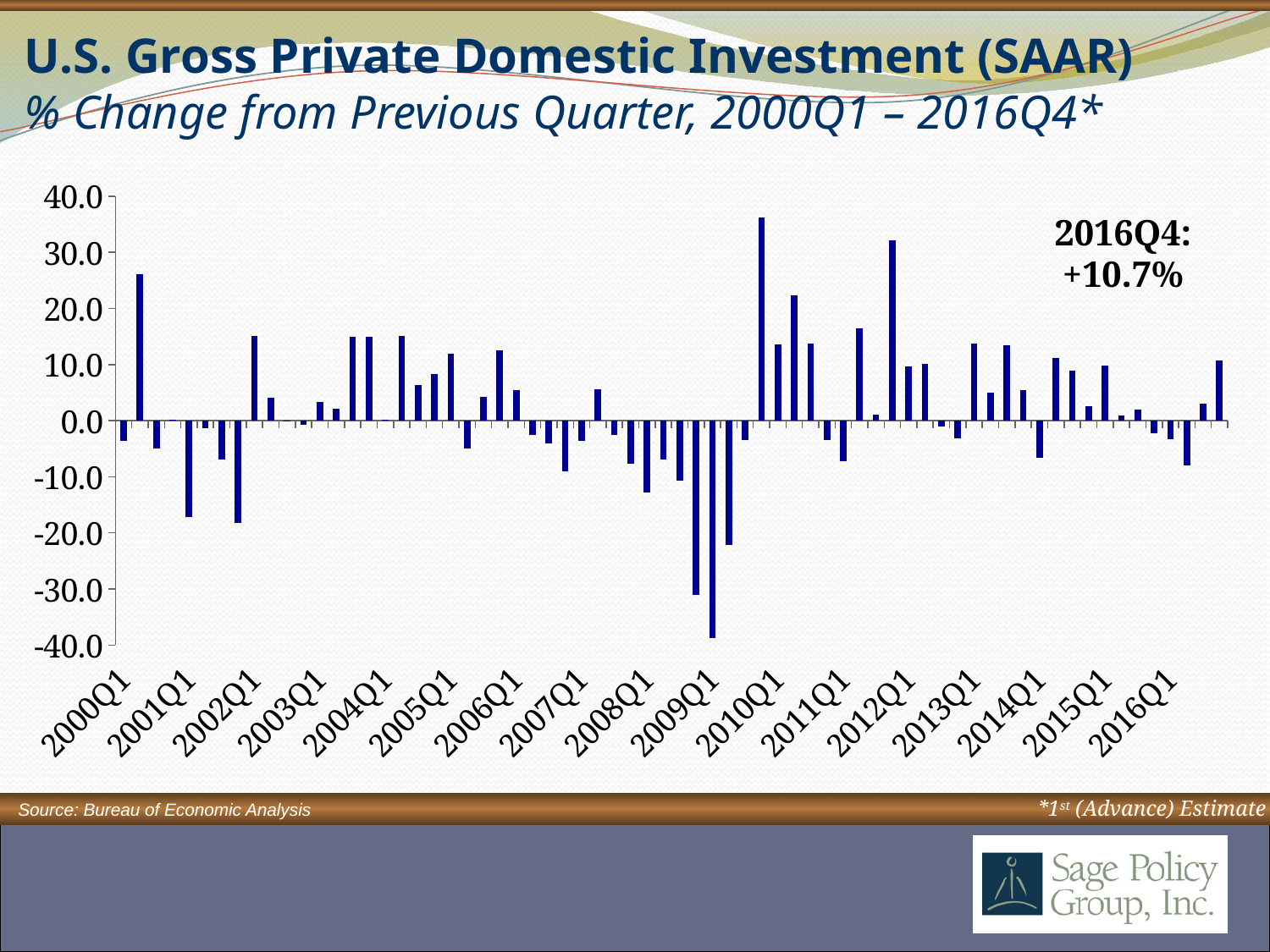
Is the value for 2016Q4 greater or less than 10? greater Is the value for 2016Q1 greater or less than 0? less Is the highest bar on the chart greater or less than 30? greater What is the value for 2016Q4? +10.7% What is the highest value shown on the y axis? 40.0 What kind of chart is shown on the slide? bar chart What is the title of the chart? U.S. Gross Private Domestic Investment (SAAR)